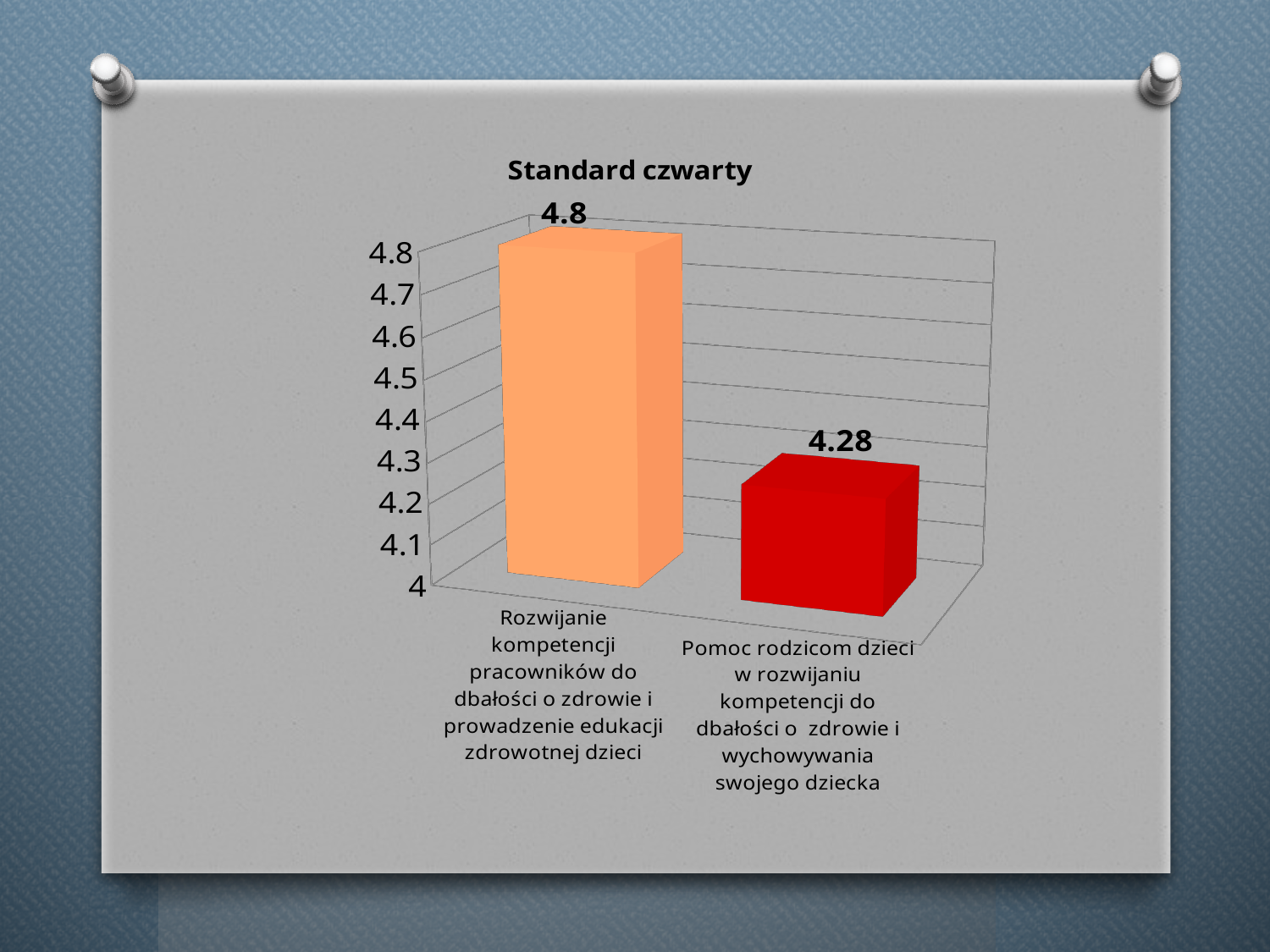
Is the value for "Rozwijanie kompetencji pracowników..." greater or less than 4.5? greater Which is larger: the value for "Rozwijanie kompetencji pracowników..." or the value for "Pomoc rodzicom dzieci..."? Rozwijanie kompetencji pracowników do dbałości o zdrowie i prowadzenie edukacji zdrowotnej dzieci Which category has the highest value? Rozwijanie kompetencji pracowników do dbałości o zdrowie i prowadzenie edukacji zdrowotnej dzieci What colour is the bar for "Pomoc rodzicom dzieci..."? red What is the value for "Pomoc rodzicom dzieci w rozwijaniu kompetencji do dbałości o zdrowie i wychowywania swojego dziecka"? 4.28 Is the value for "Pomoc rodzicom dzieci..." greater or less than 4.5? less What is the title of the chart? Standard czwarty What kind of chart is shown on the slide? bar chart Which category has the lowest value? Pomoc rodzicom dzieci w rozwijaniu kompetencji do dbałości o zdrowie i wychowywania swojego dziecka How many categories are shown in the chart? 2 What is the difference between the two bars' values? 0.52 What is the value for "Rozwijanie kompetencji pracowników do dbałości o zdrowie i prowadzenie edukacji zdrowotnej dzieci"? 4.8